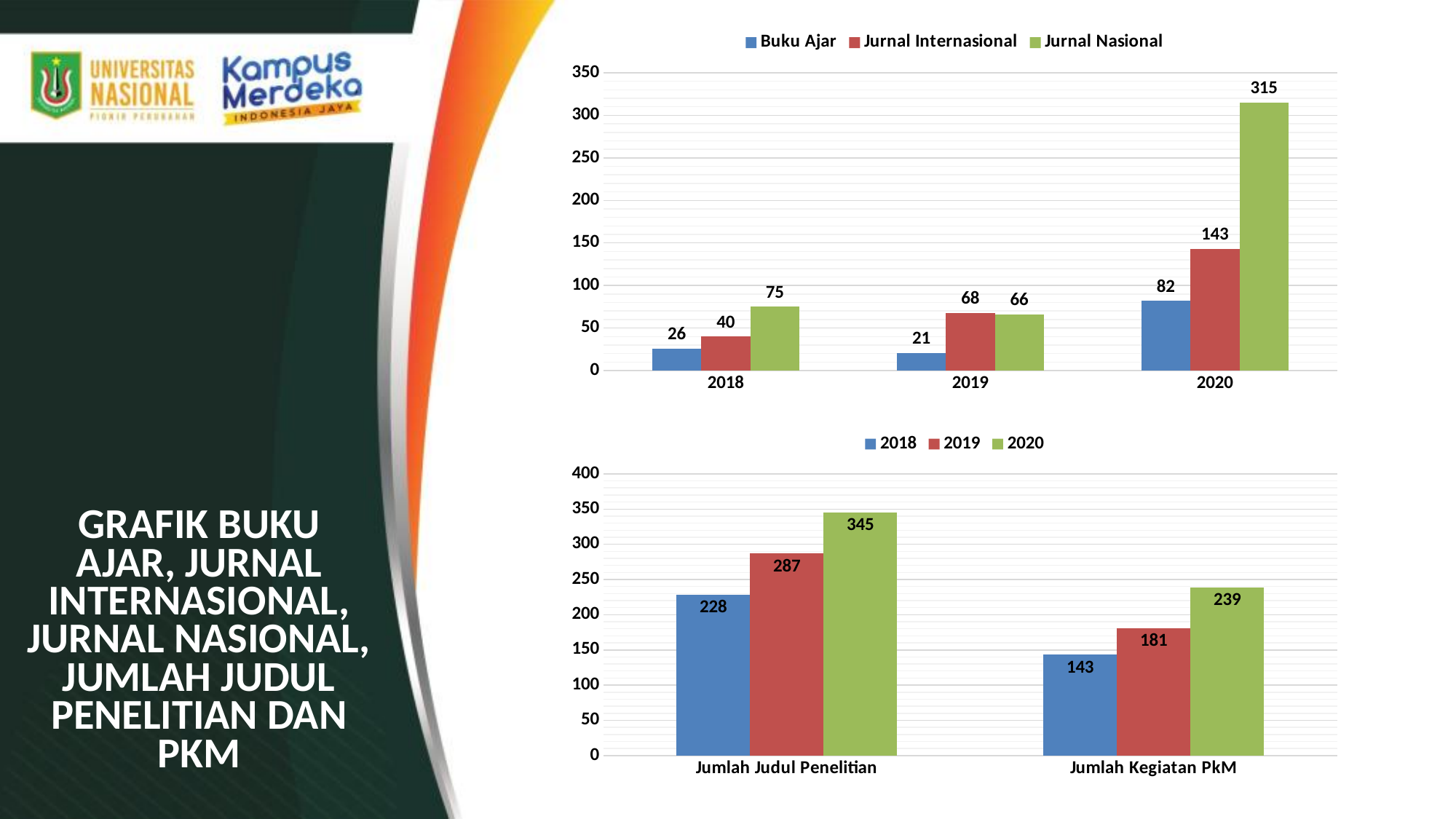
In the top chart, which is larger in 2019: Jurnal Internasional or Jurnal Nasional? Jurnal Internasional In the top chart, how many series does the legend list? 3 What kind of chart is the bottom chart? bar chart In the bottom chart, how many categories are shown on the x axis? 2 In the bottom chart, what is the value for 2019 for Jumlah Kegiatan PkM? 181 In the top chart, what is the value for Jurnal Nasional in 2020? 315 In the top chart, which year has the highest value for Jurnal Internasional? 2020 In the top chart, which year has the lowest value for Buku Ajar? 2019 In the top chart, does the value for Buku Ajar rise or fall from 2019 to 2020? rise In the bottom chart, what is the difference between the 2020 and 2018 values for Jumlah Judul Penelitian? 117 In the top chart, what is the difference between Jurnal Nasional and Jurnal Internasional in 2020? 172 In the top chart, what is the value for Buku Ajar in 2019? 21